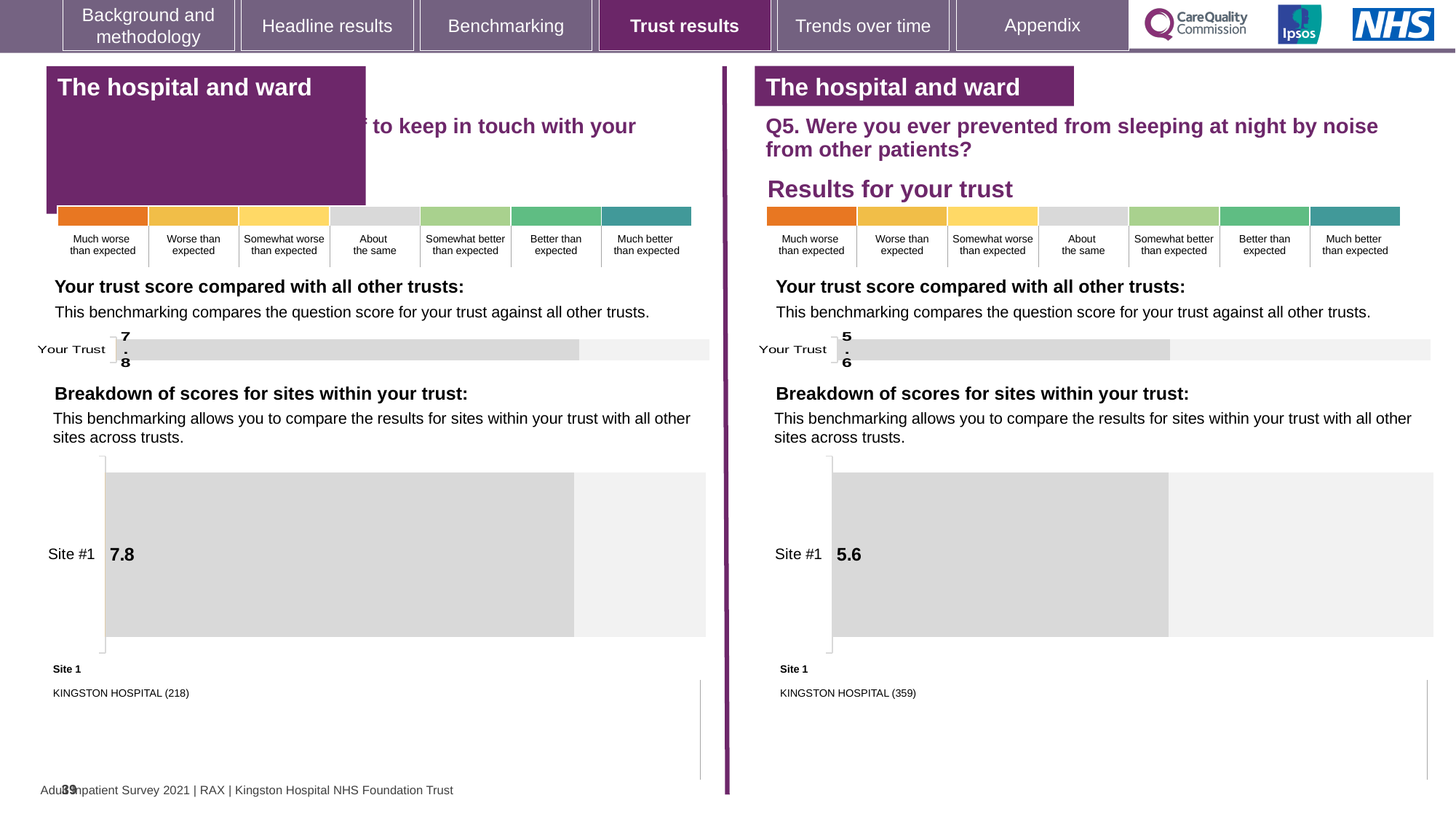
What type of chart is used for the 'Breakdown of scores for sites within your trust' on the right-hand side of the slide? Bar chart How many sites are plotted in the right-hand 'Breakdown of scores for sites within your trust' chart? 1 On the left-hand side of the slide, what is the value shown for Your Trust in the 'Your trust score compared with all other trusts' chart? 7.8 In the right-hand breakdown chart, which hospital is listed as Site 1? KINGSTON HOSPITAL (359) Which is larger: the Site #1 score in the left-hand breakdown chart or the Site #1 score in the right-hand breakdown chart? The left-hand chart (7.8) On the right-hand side of the slide (Q5), what is the value shown for Your Trust in the 'Your trust score compared with all other trusts' chart? 5.6 In the left-hand breakdown chart, which hospital is listed as Site 1? KINGSTON HOSPITAL (218) What type of chart is used to show 'Your Trust' score on the left-hand side of the slide? Bar chart In the left-hand 'Breakdown of scores for sites within your trust' chart, what is the score for Site #1? 7.8 In the right-hand 'Breakdown of scores for sites within your trust' chart, what is the score for Site #1? 5.6 How many sites are plotted in the left-hand 'Breakdown of scores for sites within your trust' chart? 1 What is the difference between the Site #1 score in the left-hand breakdown chart (7.8) and the Site #1 score in the right-hand breakdown chart (5.6)? 2.2